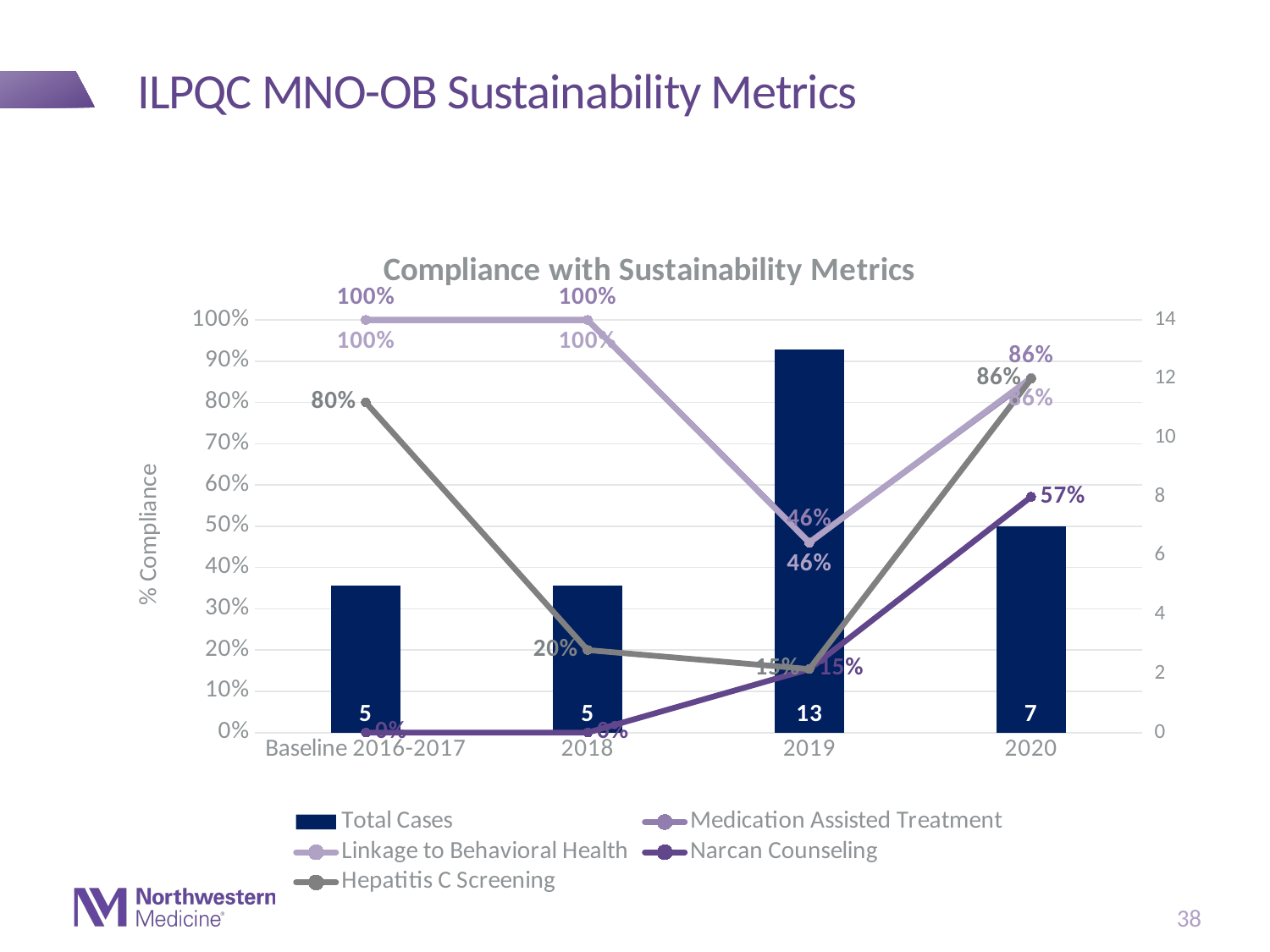
Does Narcan Counseling compliance rise or fall from 2018 to 2020? Rise Which year has the highest number of Total Cases? 2019 What is the Hepatitis C Screening compliance at Baseline 2016-2017? 80% How many series does the legend list? 5 What is the Narcan Counseling compliance in 2020? 57% How many time periods are shown on the x axis? 4 What is the Hepatitis C Screening compliance in 2018? 20% What is the title of the chart? Compliance with Sustainability Metrics What is the difference in Total Cases between 2019 and 2020? 6 What is the value of Total Cases in 2019? 13 Which is higher, Hepatitis C Screening compliance in 2018 or in 2019? 2018 What kind of chart is this? Combination bar and line chart